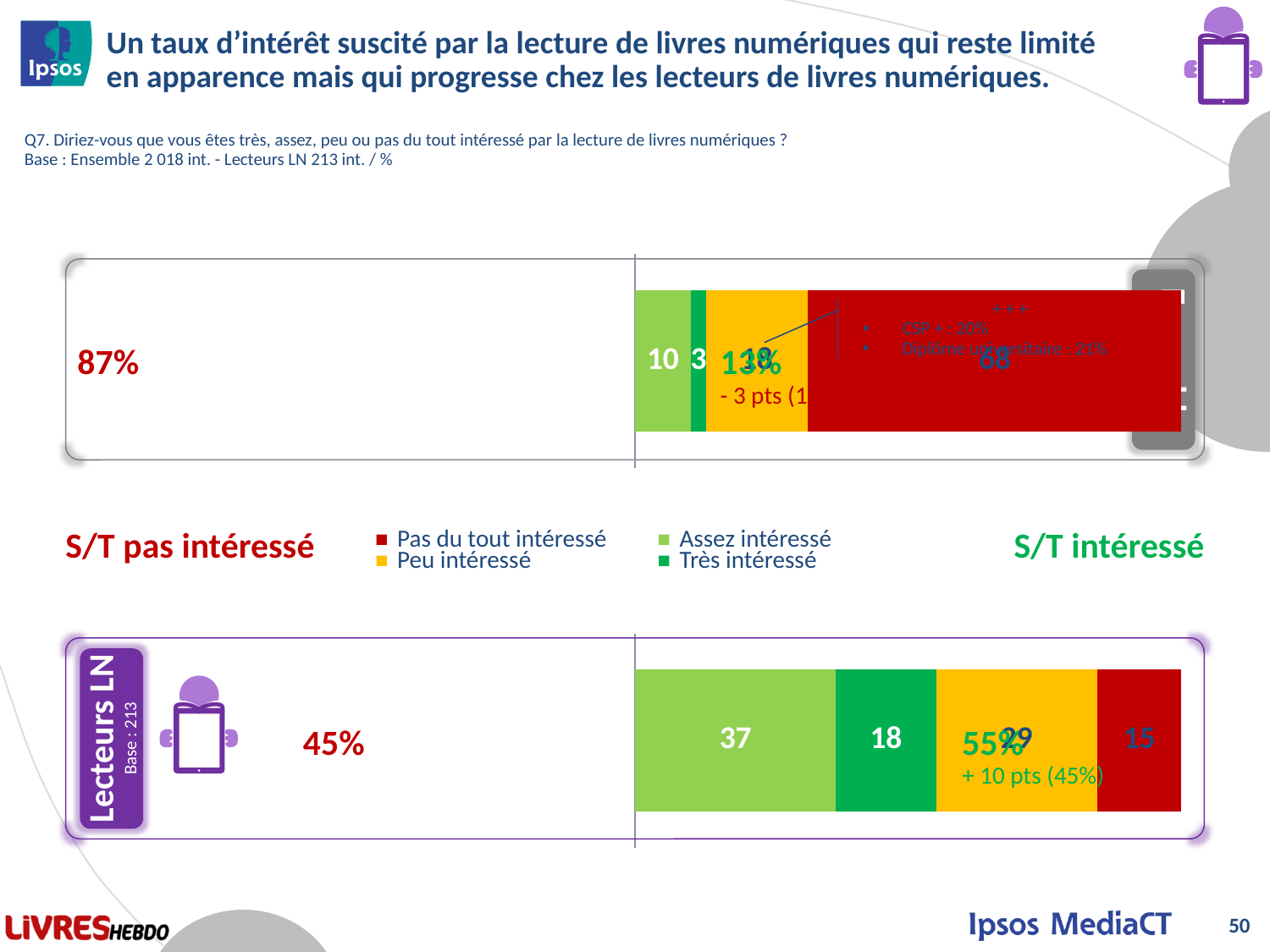
In the bottom chart (Lecteurs LN), what is the S/T intéressé percentage shown? 55% In the top chart (Ensemble), what is the value for "Assez intéressé"? 10 In the bottom chart (Lecteurs LN), what is the value for "Assez intéressé"? 37 In the top chart (Ensemble), what is the value for "Très intéressé"? 3 How many series does the legend list? 4 In the bottom chart (Lecteurs LN), which category has the highest value? Assez intéressé What kind of chart is used on this slide? Stacked bar chart In the top chart (Ensemble), what is the S/T pas intéressé percentage shown? 87% In the bottom chart (Lecteurs LN), what is the difference between "Assez intéressé" and "Très intéressé"? 19 In the bottom chart (Lecteurs LN), what is the value for "Pas du tout intéressé"? 15 In the bottom chart (Lecteurs LN), what is the S/T pas intéressé percentage shown? 45% In the bottom chart (Lecteurs LN), what is the value for "Très intéressé"? 18